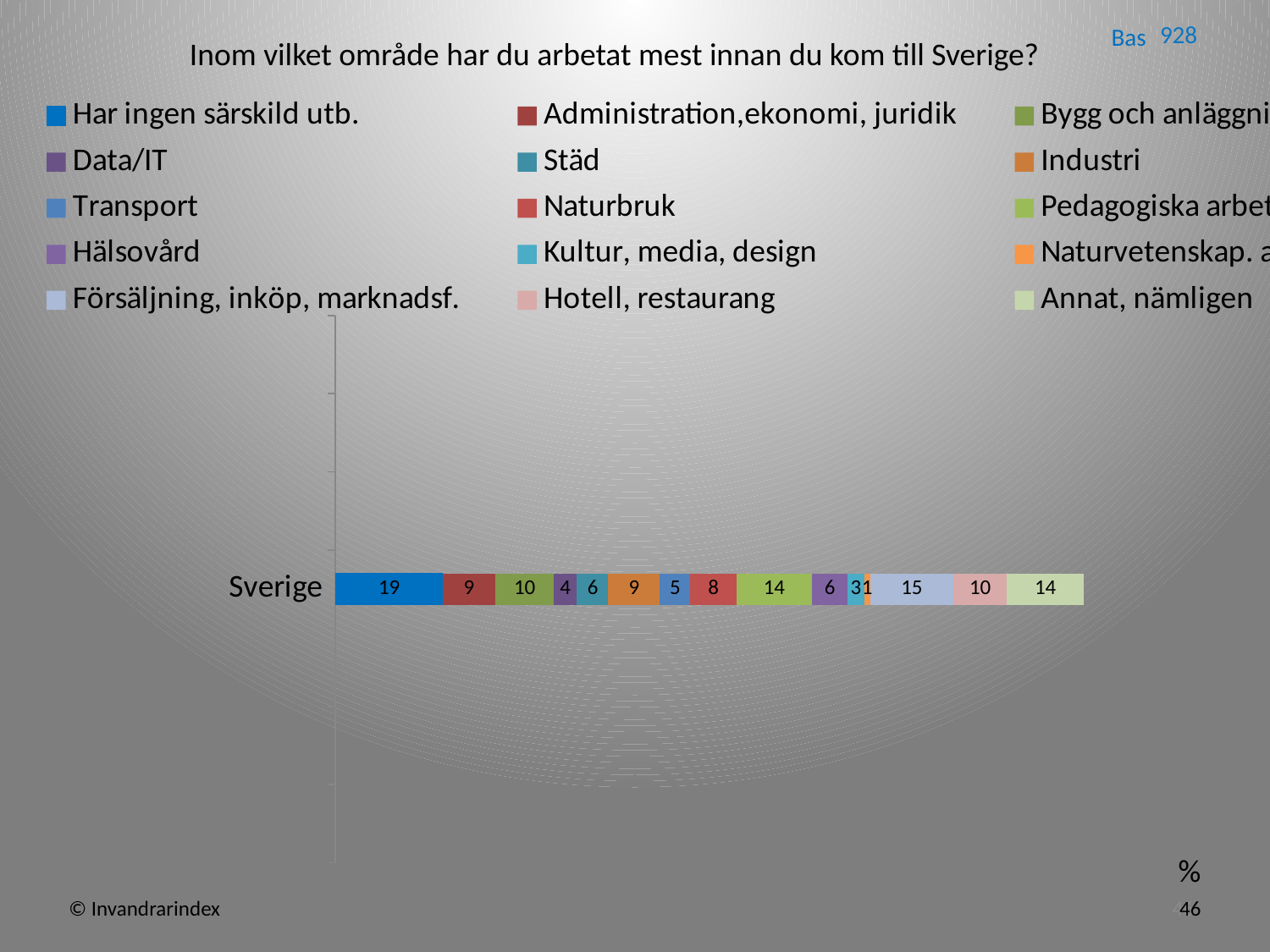
What is the value for "Data/IT" in the Sverige bar? 4 Which series has the largest segment in the Sverige bar? Har ingen särskild utb. What is the value for "Annat, nämligen" in the Sverige bar? 14 What is the base (Bas) shown in the top right corner of the slide? 928 Which is larger, the value for "Naturbruk" or the value for "Transport"? Naturbruk What is the difference between the values for "Har ingen särskild utb." and "Försäljning, inköp, marknadsf."? 4 What kind of chart is shown on the slide? bar chart What is the value for "Försäljning, inköp, marknadsf." in the Sverige bar? 15 What is the value for "Hotell, restaurang" in the Sverige bar? 10 How many series does the legend list? 15 How many categories are plotted on the chart? 1 What is the value for "Har ingen särskild utb." in the Sverige bar? 19